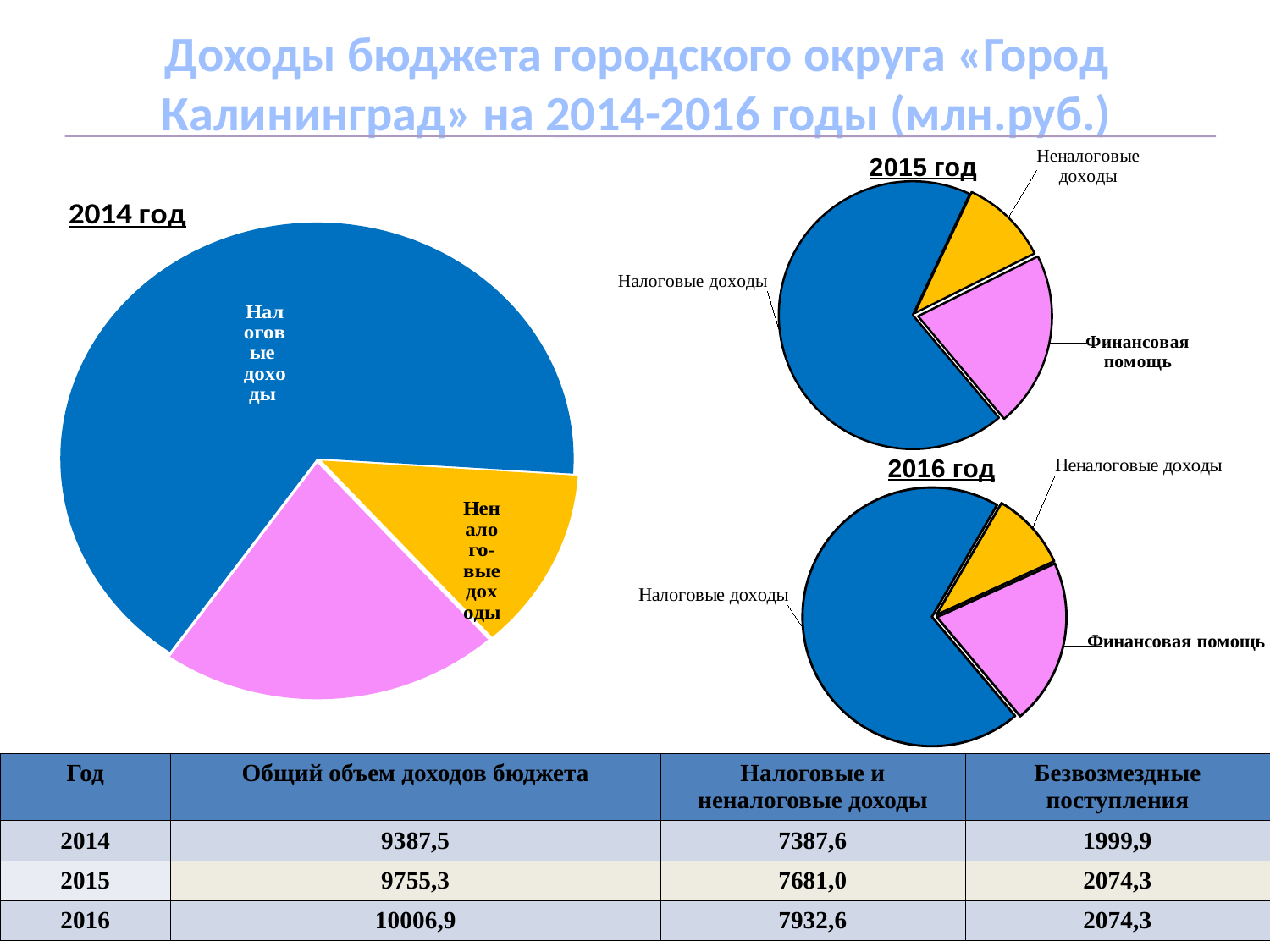
In the 2014 год pie chart, which labelled category has the smallest slice? Неналоговые доходы What kind of chart is the 2014 год chart? pie chart How many pie charts are shown on the slide? 3 In the 2015 год pie chart, which category has the smallest slice? Неналоговые доходы In the 2016 год pie chart, which slice is larger: Финансовая помощь or Неналоговые доходы? Финансовая помощь In the 2015 год pie chart, which category has the largest slice? Налоговые доходы In the 2015 год pie chart, what colour is the Налоговые доходы slice? blue In the 2016 год pie chart, which category has the largest slice? Налоговые доходы How many slices does the 2015 год pie chart have? 3 How many slices does the 2016 год pie chart have? 3 In the 2014 год pie chart, which slice is larger: Налоговые доходы or Неналоговые доходы? Налоговые доходы In the 2016 год pie chart, what colour is the Финансовая помощь slice? pink